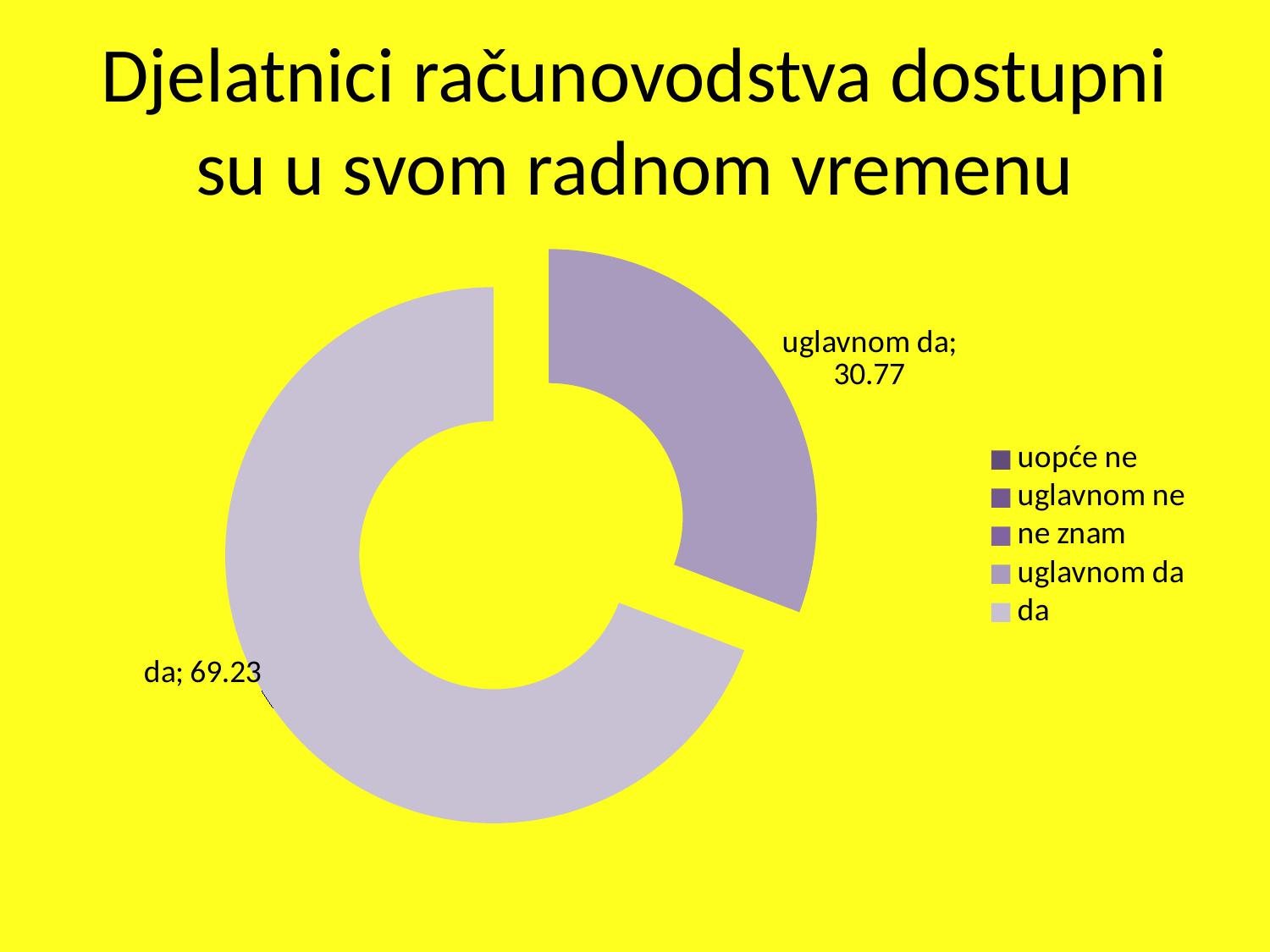
Which labelled slice has the largest value? da What is the value shown for the "da" slice? 69.23 What is the title of the slide? Djelatnici računovodstva dostupni su u svom radnom vremenu Which labelled slice has the smallest value? uglavnom da What is the total of the two labelled slice values? 100 What is the value shown for the "uglavnom da" slice? 30.77 How many entries does the legend list? 5 How many slices have data labels printed on the chart? 2 What is the difference between the values for "da" and "uglavnom da"? 38.46 Which legend entry is listed first? uopće ne Which is larger, the value for "da" or the value for "uglavnom da"? da What kind of chart is shown on the slide? Doughnut (pie) chart